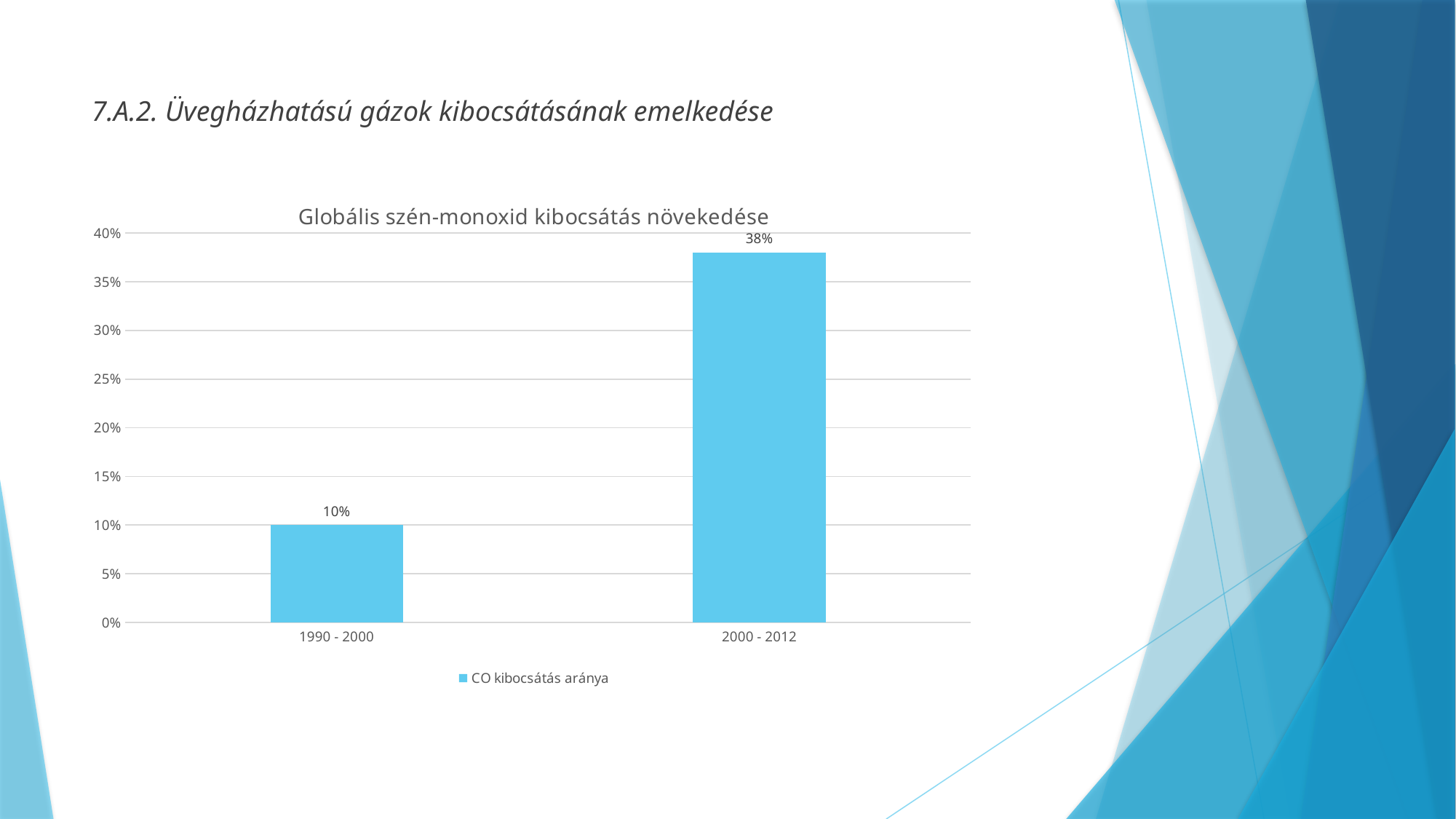
What is the title of the chart? Globális szén-monoxid kibocsátás növekedése How many series does the legend list? 1 What kind of chart is shown on the slide? bar chart Which period has the lowest value? 1990 - 2000 What is the value for 1990 - 2000? 10% What is the difference between the values for 2000 - 2012 and 1990 - 2000? 28% Which period has the highest value? 2000 - 2012 Is the value for 2000 - 2012 greater or less than 35%? greater Which is larger, the value for 1990 - 2000 or the value for 2000 - 2012? 2000 - 2012 How many categories are shown on the x axis? 2 What is the value for 2000 - 2012? 38% Do the values rise or fall from 1990 - 2000 to 2000 - 2012? rise